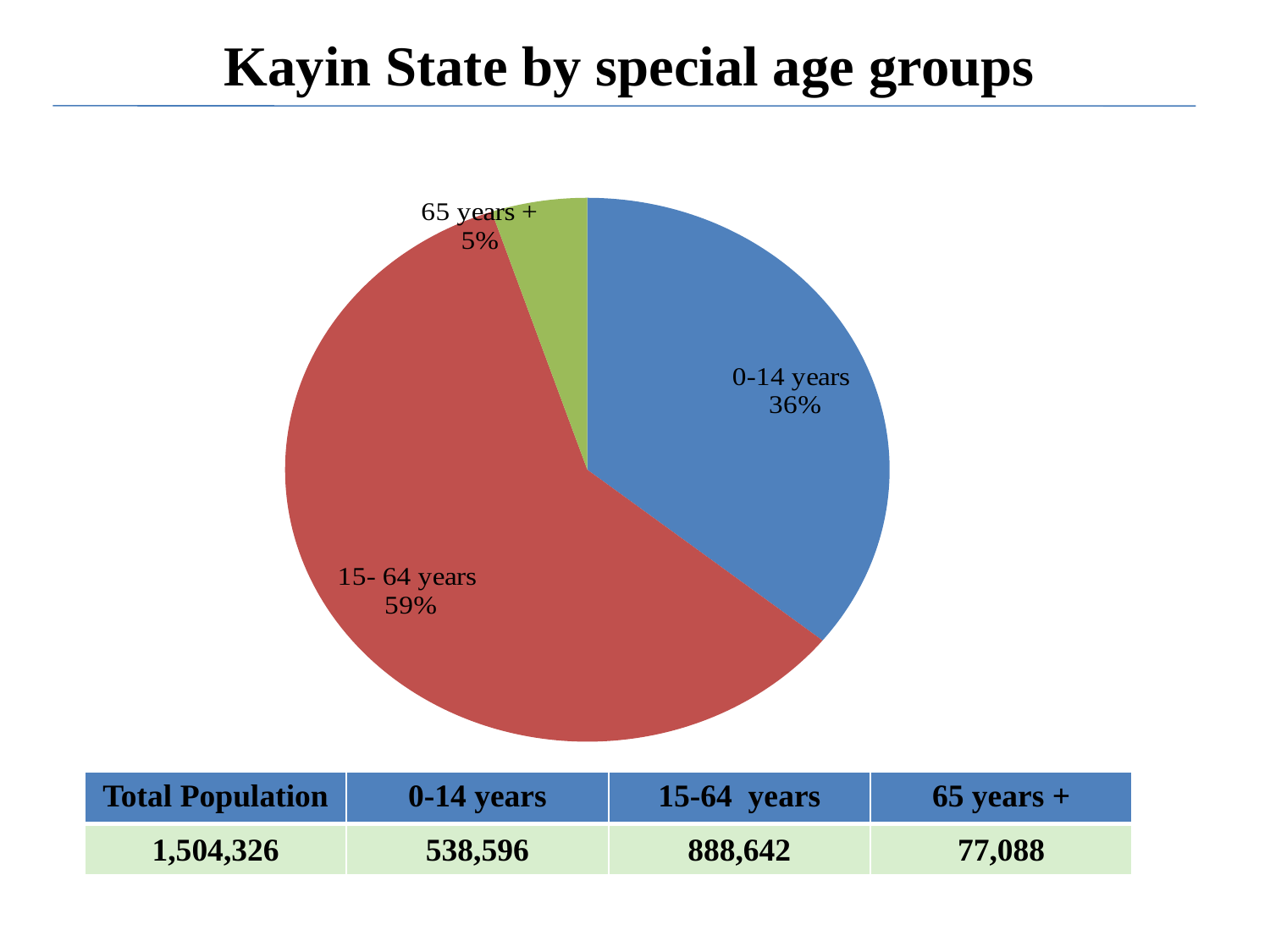
What share of the pie does the 0-14 years slice represent? 36% What share of the pie does the 15-64 years slice represent? 59% Which age group has the largest slice of the pie? 15- 64 years What is the difference in percentage points between the 15-64 years slice and the 0-14 years slice? 23 What is the title of the chart? Kayin State by special age groups Which slice is larger, 0-14 years or 65 years +? 0-14 years How many slices does the pie chart have? 3 Which age group has the smallest slice of the pie? 65 years + What is the difference in percentage points between the 0-14 years slice and the 65 years + slice? 31 What kind of chart is shown on the slide? pie chart What share of the pie does the 65 years + slice represent? 5% What colour is the 15- 64 years slice? red